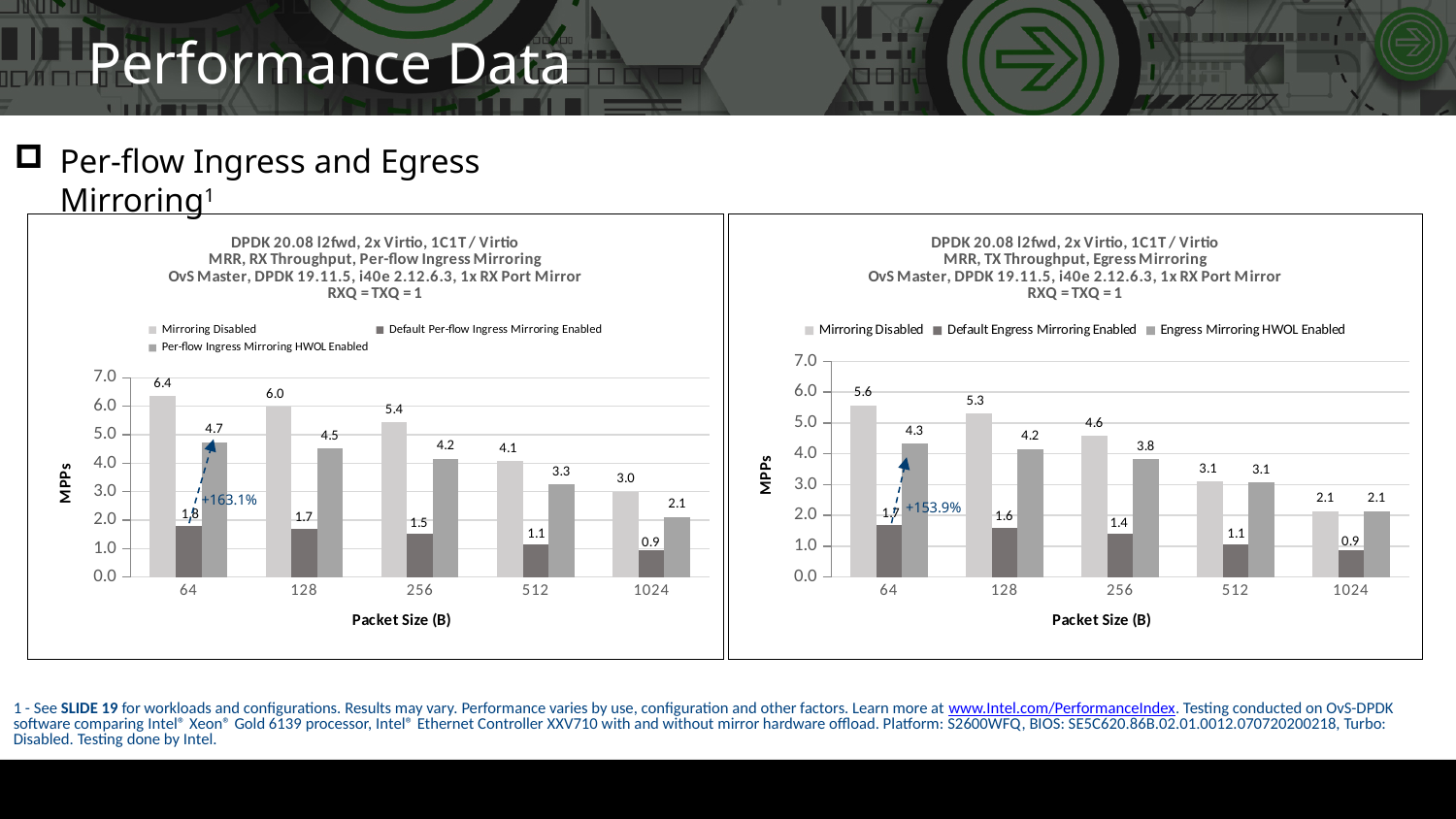
In the left chart (RX Throughput, Per-flow Ingress Mirroring), what is the MPPs value for Mirroring Disabled at packet size 64? 6.4 In the right chart (TX Throughput, Egress Mirroring), what is the value for Default Engress Mirroring Enabled at packet size 128? 1.6 In the right chart (TX Throughput, Egress Mirroring), what is the value for Engress Mirroring HWOL Enabled at packet size 512? 3.1 In the left chart, which is larger at packet size 512: Mirroring Disabled or Per-flow Ingress Mirroring HWOL Enabled? Mirroring Disabled How many packet size categories are shown on the x axis of the right chart? 5 In the right chart, which packet size has the highest value for Mirroring Disabled? 64 In the left chart, what is the difference between Mirroring Disabled and Per-flow Ingress Mirroring HWOL Enabled at packet size 64? 1.7 In the left chart, which packet size has the lowest value for Default Per-flow Ingress Mirroring Enabled? 1024 In the right chart, what is the difference between Engress Mirroring HWOL Enabled and Default Engress Mirroring Enabled at packet size 256? 2.4 In the left chart (RX Throughput, Per-flow Ingress Mirroring), what is the value for Per-flow Ingress Mirroring HWOL Enabled at packet size 256? 4.2 How many series does the legend of the left chart list? 3 What type of chart is the right chart (TX Throughput, Egress Mirroring)? Bar chart